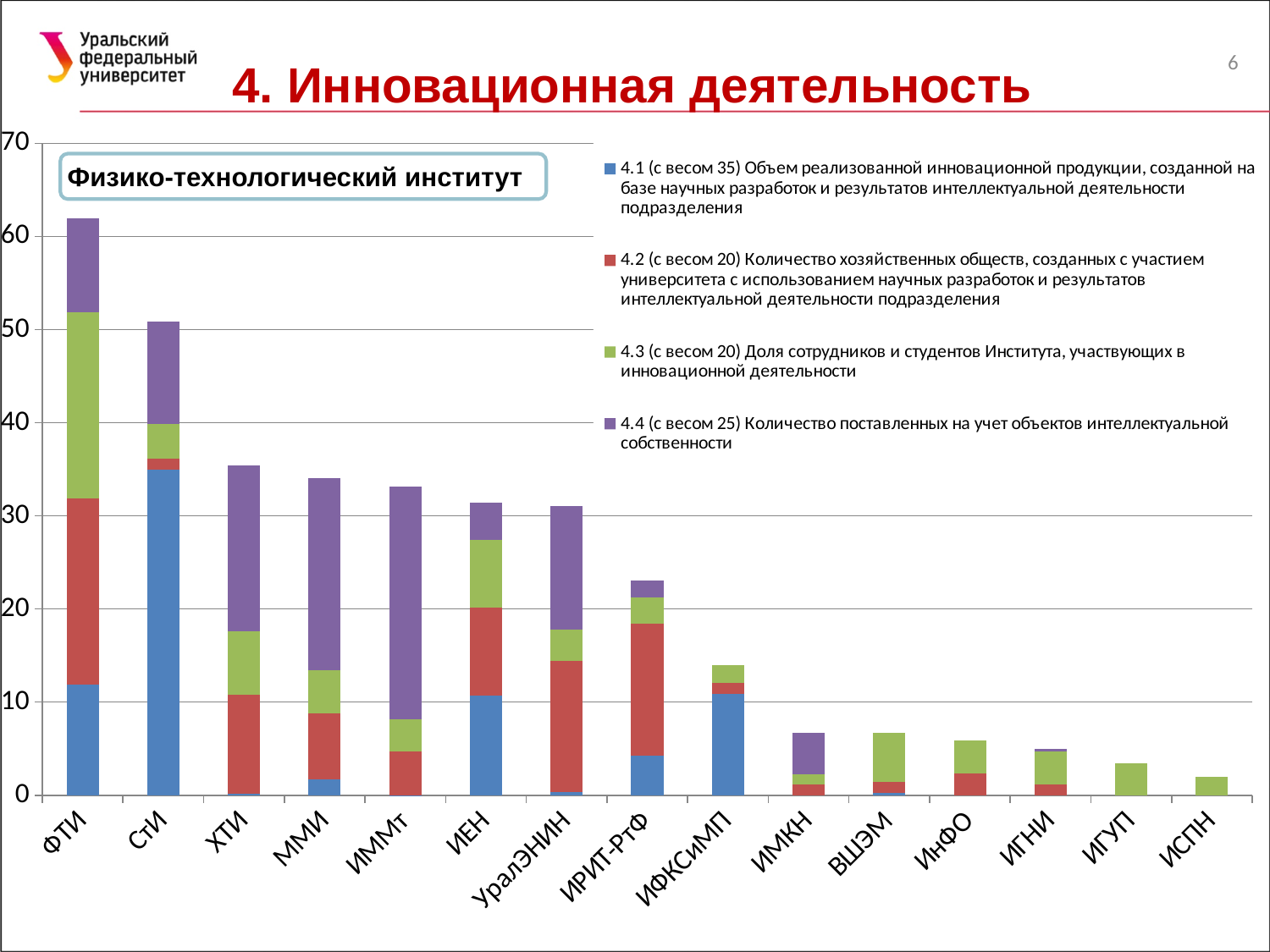
Is the total value for ИМКН greater or less than 10? less Is the total value for ХТИ greater or less than 30? greater What kind of chart is shown on the slide? Stacked bar chart Which institute is named in the highlighted box at the top of the chart? Физико-технологический институт Which institute has the lowest total bar in the chart? ИСПН Which has the larger total bar, ФТИ or СтИ? ФТИ How many series does the chart's legend list? 4 How many institutes (categories) are shown along the x axis of the chart? 15 Do the total bar heights rise or fall moving from left to right along the x axis? fall Which has the larger total bar, ИЕН or ИРИТ-РтФ? ИЕН Is the total value for ФТИ greater or less than 50? greater Which institute has the highest total bar in the chart? ФТИ